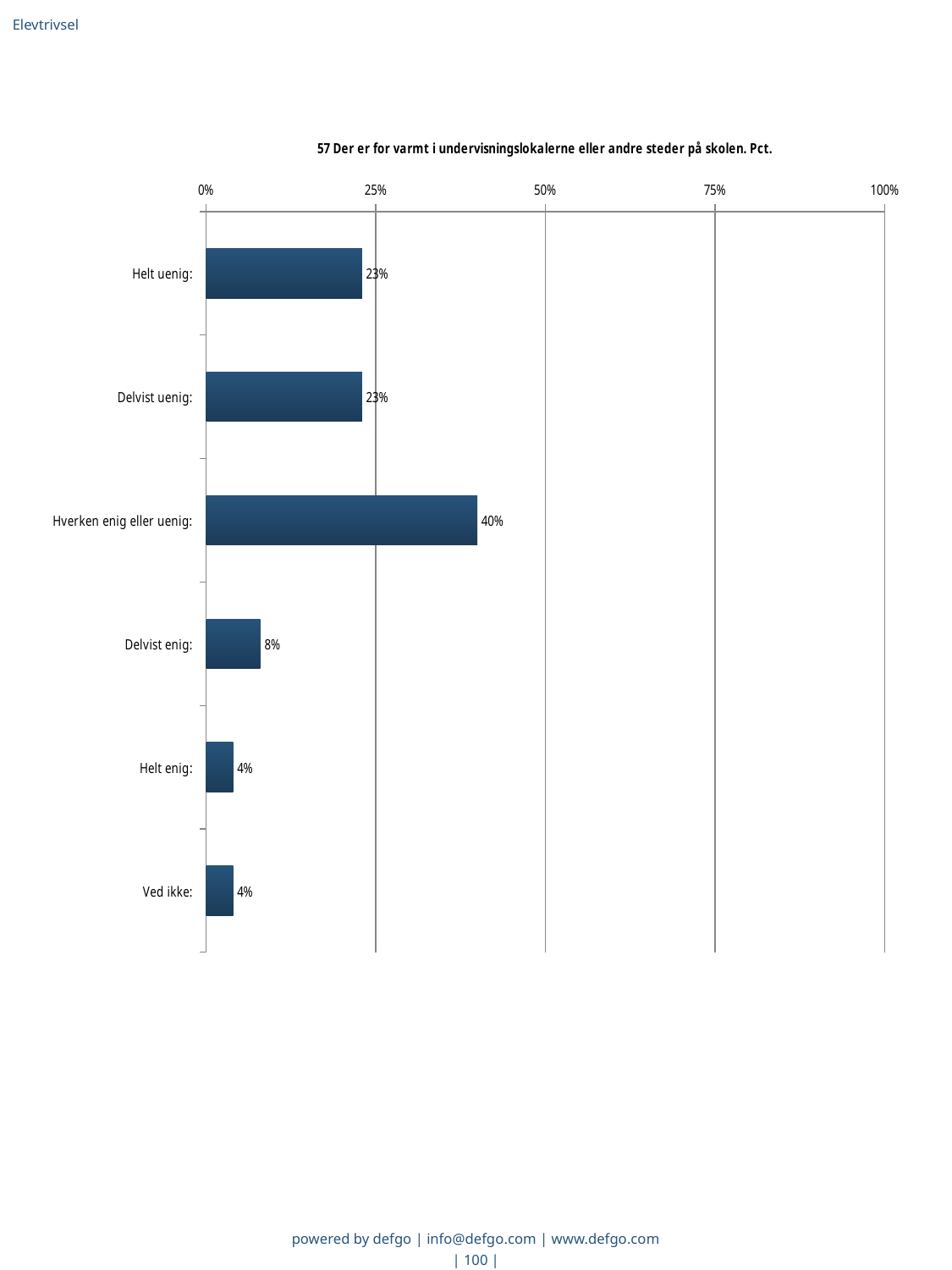
How many categories are shown in the chart? 6 What is the difference between the values for "Hverken enig eller uenig" and "Delvist uenig"? 17% What is the value for "Delvist enig"? 8% What kind of chart is shown on the slide? Bar chart What is the value for "Hverken enig eller uenig"? 40% What is the title of the chart? 57 Der er for varmt i undervisningslokalerne eller andre steder på skolen. Pct. Is the value for "Hverken enig eller uenig" greater or less than 25%? greater Which category has the highest value? Hverken enig eller uenig What is the difference between the values for "Delvist enig" and "Helt enig"? 4% What is the value for "Helt uenig"? 23% What is the value for "Ved ikke"? 4% Which is larger, the value for "Delvist uenig" or the value for "Delvist enig"? Delvist uenig